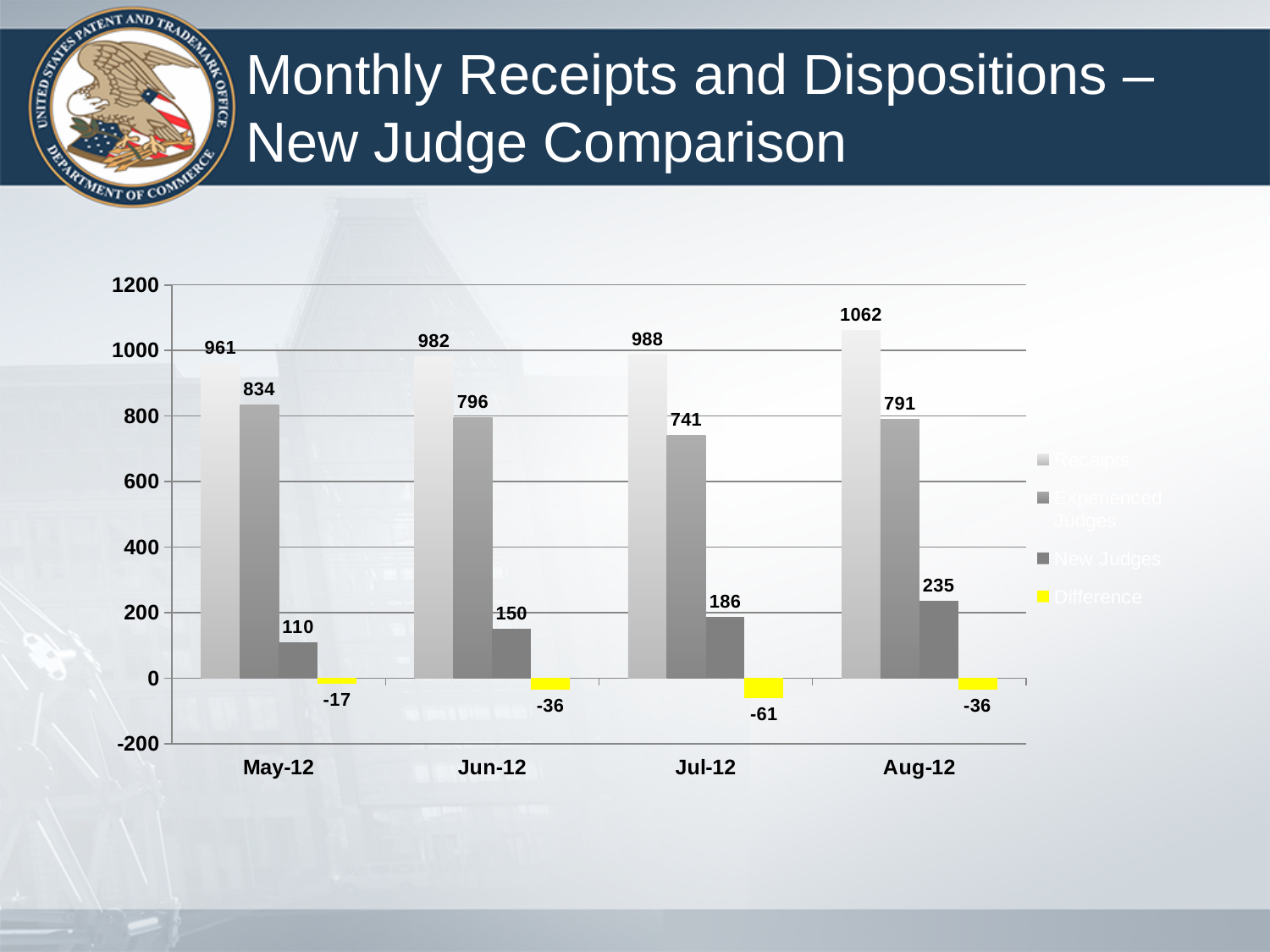
Which is larger: Experienced Judges in May-12 or Experienced Judges in Aug-12? May-12 Do the New Judges values rise or fall from May-12 to Aug-12? Rise What is the value of Receipts for Aug-12? 1062 How many months are shown on the x axis? 4 In which month is the Receipts value highest? Aug-12 What is the value for Experienced Judges in Jun-12? 796 What is the value for New Judges in Jul-12? 186 What is the Difference value shown for May-12? -17 How many series does the legend list? 4 What kind of chart is shown on the slide? Bar chart What is the difference between Receipts and Experienced Judges in May-12? 127 In which month is the New Judges value lowest? May-12